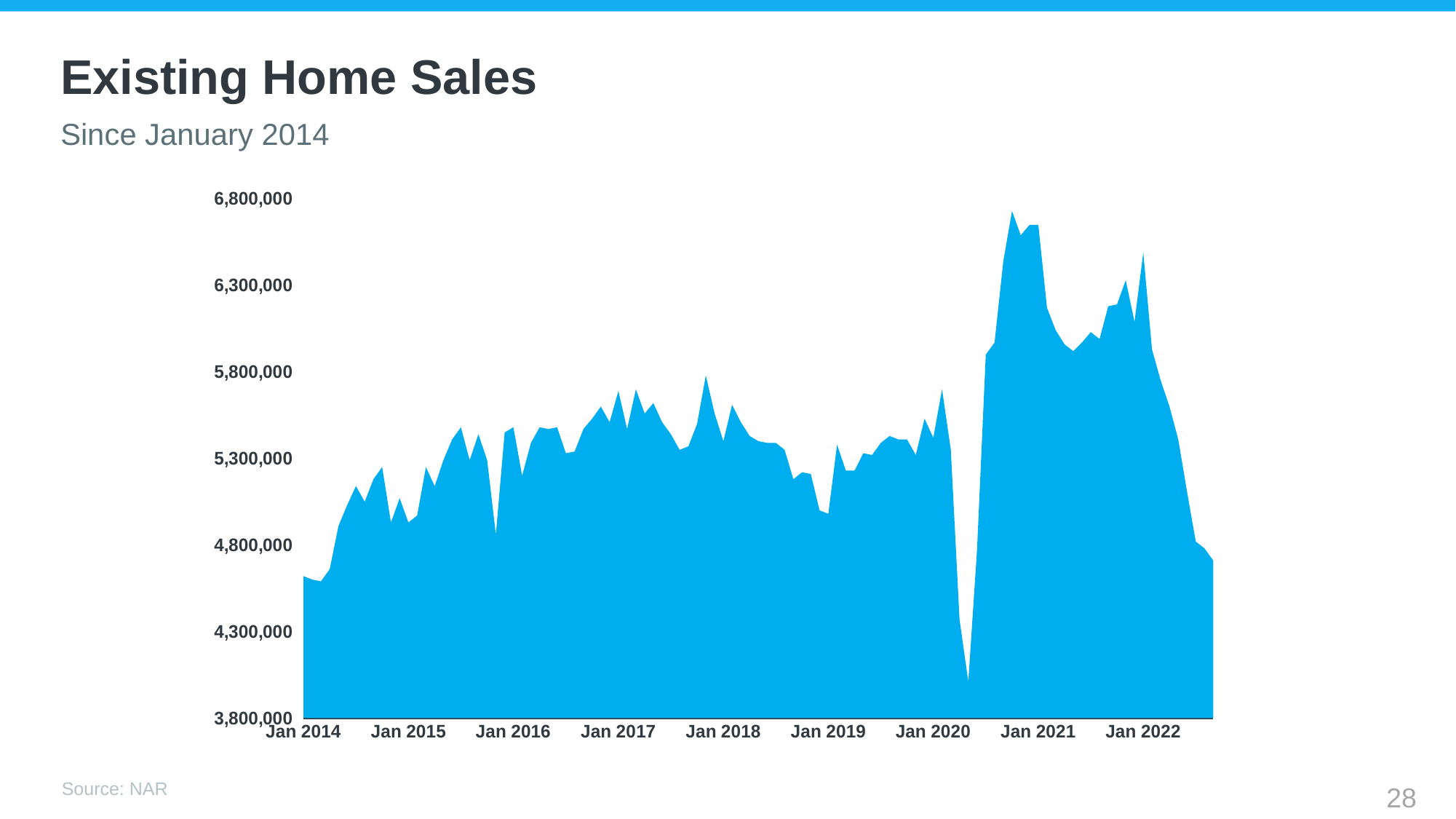
Is the value for Jan 2014 greater or less than 4,800,000? less What kind of chart is shown on the slide? Area chart What source is cited for the chart? NAR Is the value for Jan 2022 greater or less than 5,800,000? greater Is the value for Jan 2019 greater or less than 5,300,000? less How many year labels are shown on the x axis? 9 Do the values rise or fall from Jan 2022 to the end of the chart? fall Do the values rise or fall from Jan 2014 to Jan 2015? rise What is the title of the chart on the slide? Existing Home Sales